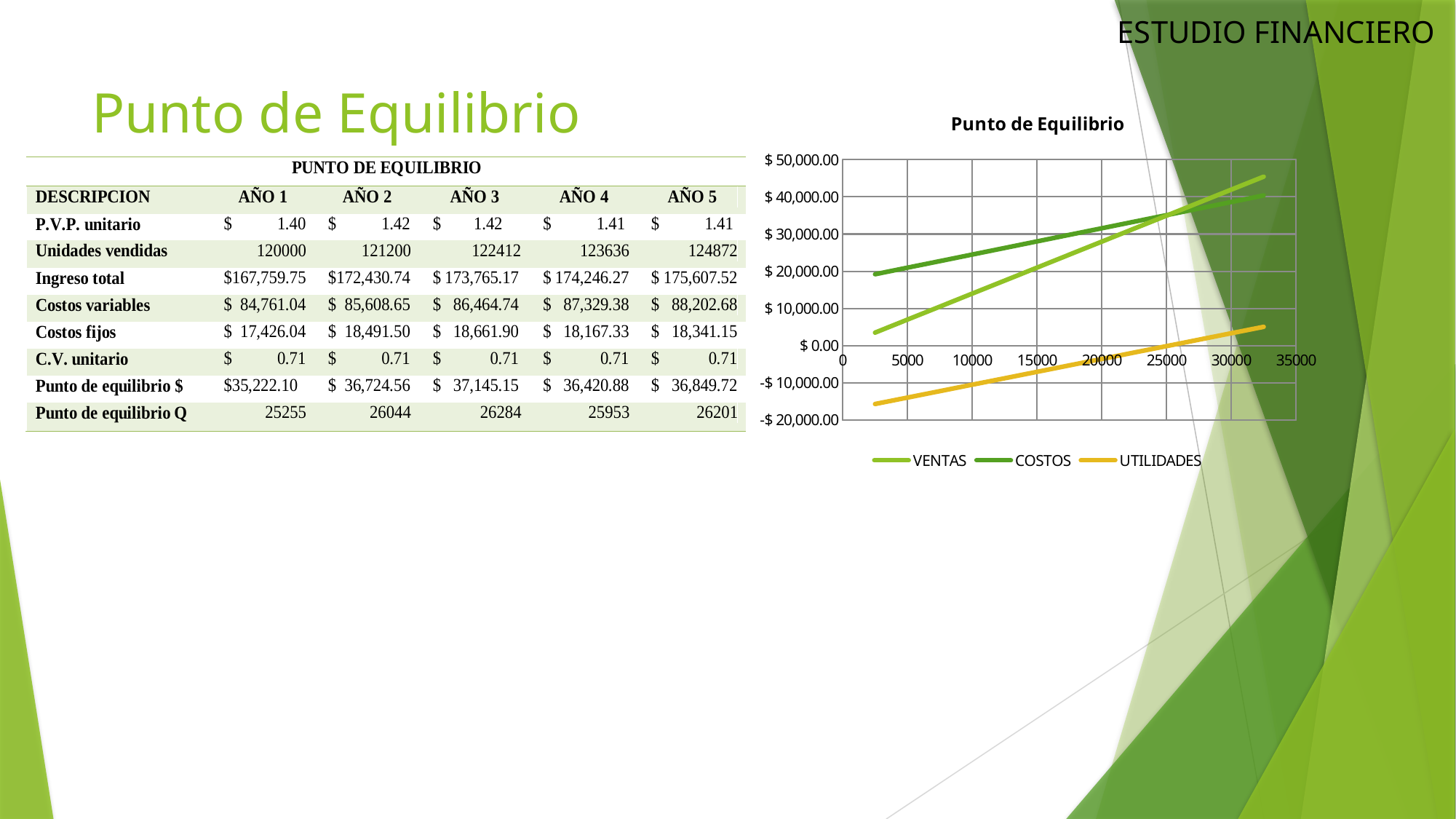
How many series does the legend of the "Punto de Equilibrio" chart list? 3 In the "Punto de Equilibrio" chart, which series is drawn in yellow? UTILIDADES In the "Punto de Equilibrio" chart, does the UTILIDADES line rise or fall as the x axis increases? rise In the "Punto de Equilibrio" chart, is the UTILIDADES value at the right end of the line greater or less than $0.00? greater In the "Punto de Equilibrio" chart, which line is higher at x = 30000, VENTAS or COSTOS? VENTAS In the "Punto de Equilibrio" chart, does the VENTAS line rise or fall as the x axis increases? rise What kind of chart is shown under the title "Punto de Equilibrio"? line chart In the "Punto de Equilibrio" chart, is the UTILIDADES value at the left end of the line greater or less than -$10,000.00? less What are the series names listed in the legend of the "Punto de Equilibrio" chart? VENTAS, COSTOS, UTILIDADES In the "Punto de Equilibrio" chart, is the VENTAS value at the right end of the line greater or less than $40,000.00? greater In the "Punto de Equilibrio" chart, which line is higher at x = 5000, VENTAS or COSTOS? COSTOS